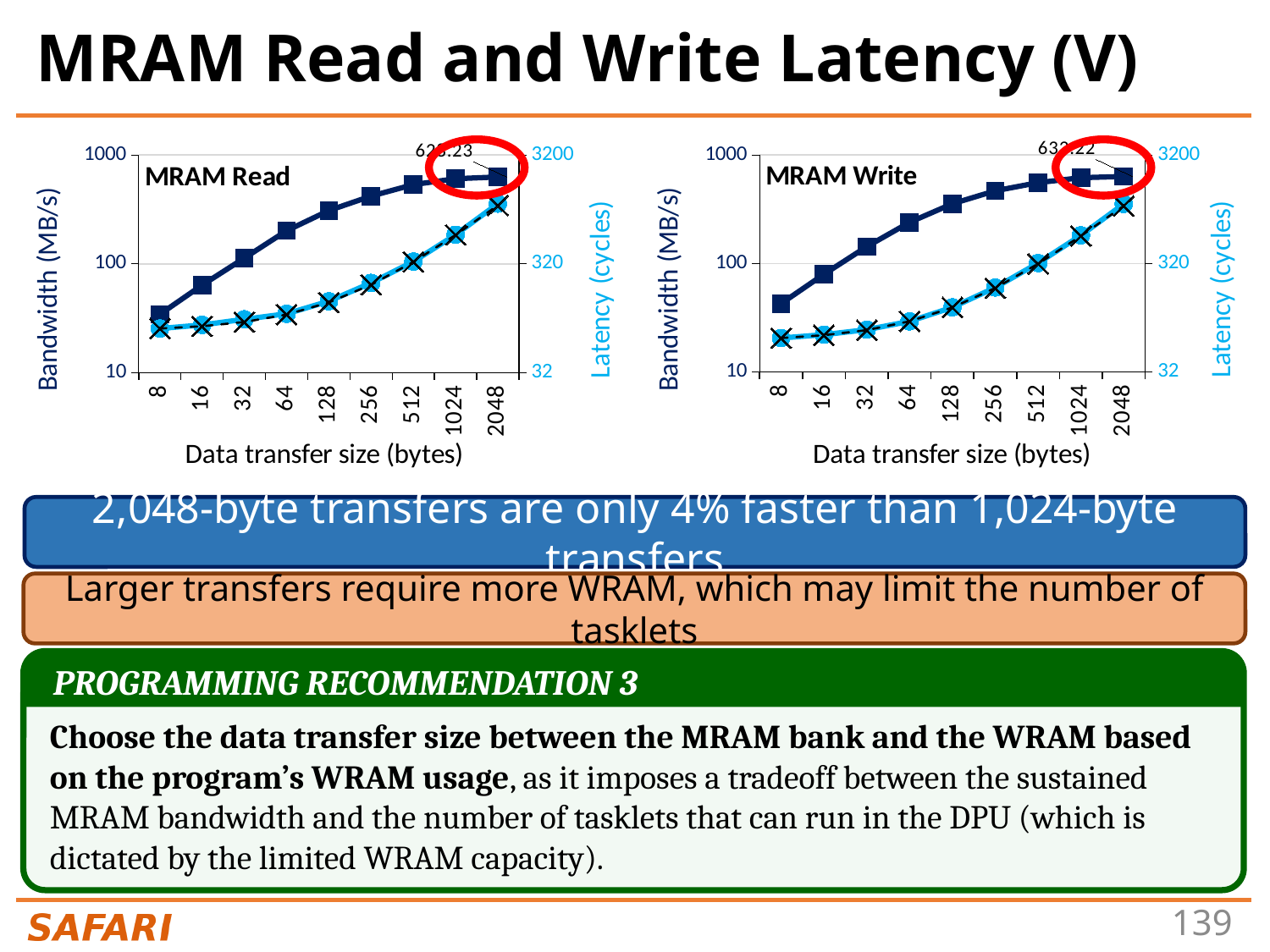
In the MRAM Read chart, does bandwidth rise or fall as the data transfer size increases? rise In the MRAM Write chart, is the bandwidth for 16 bytes greater or less than 100 MB/s? less What kind of chart is the MRAM Read chart? line chart In the MRAM Write chart, is the latency for 8 bytes greater or less than 320 cycles? less In the MRAM Read chart, which data transfer size has the lowest bandwidth? 8 In the MRAM Read chart, is the bandwidth for 64 bytes greater or less than 100 MB/s? greater How many data transfer sizes are plotted on the x axis of the MRAM Write chart? 9 In the MRAM Write chart, does latency rise or fall as the data transfer size increases? rise What is the x-axis label of the MRAM Write chart? Data transfer size (bytes) In the MRAM Write chart, which has the higher bandwidth: 8 bytes or 2048 bytes? 2048 bytes